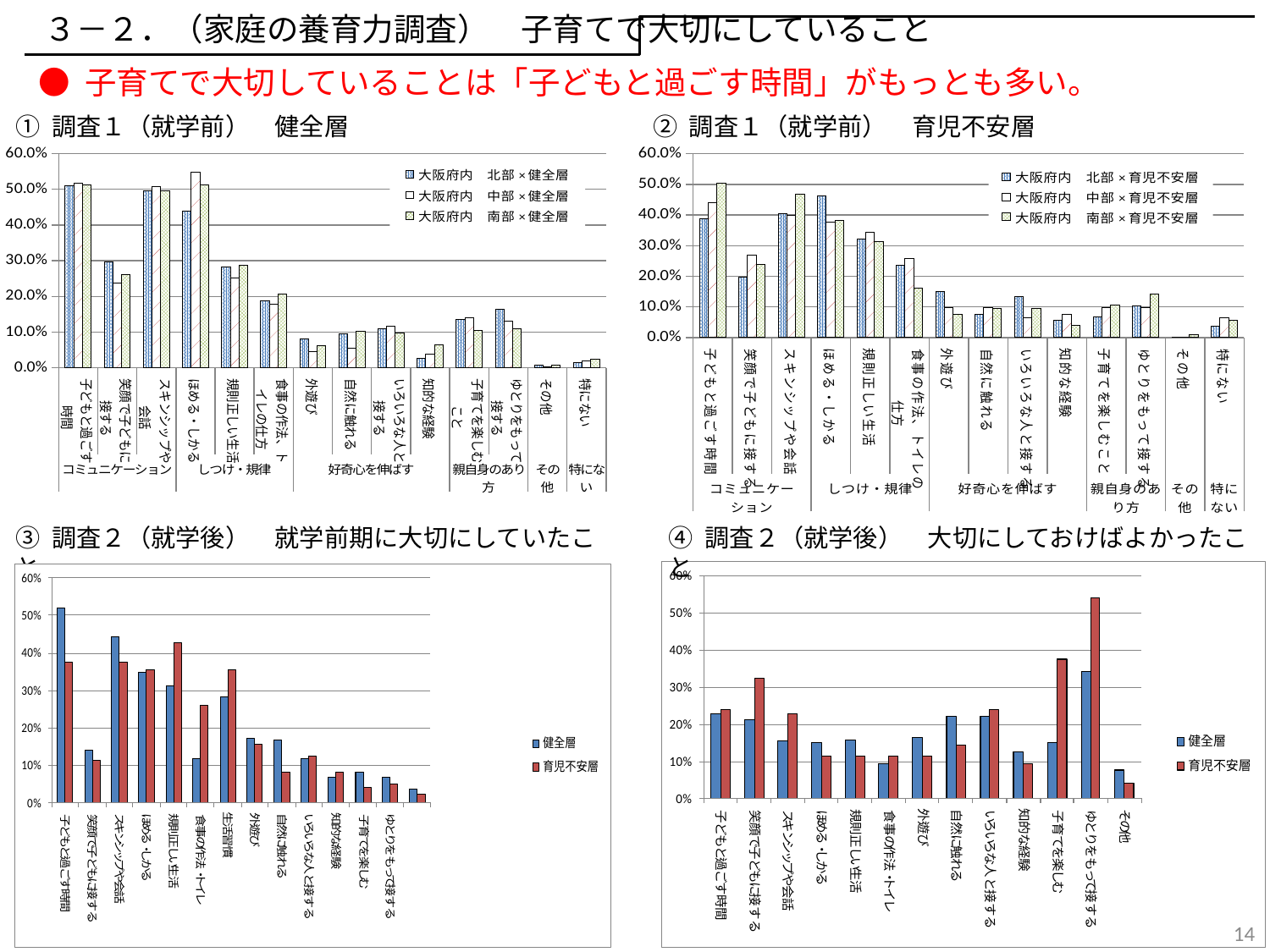
In chart ① 調査１（就学前） 健全層, how many series does the legend list? 3 In chart ② 調査１（就学前） 育児不安層, is the value of 規則正しい生活 for 大阪府内 北部×育児不安層 greater or less than 20.0%? greater In chart ④ 調査２（就学後） 大切にしておけばよかったこと, which category has the highest value for 育児不安層? ゆとりをもって接する In chart ① 調査１（就学前） 健全層, is the value of 子どもと過ごす時間 for 大阪府内 北部×健全層 greater or less than 40.0%? greater In chart ② 調査１（就学前） 育児不安層, which category has the highest value for the 大阪府内 南部×育児不安層 series? 子どもと過ごす時間 In chart ① 調査１（就学前） 健全層, which category has the highest value for the 大阪府内 中部×健全層 series? ほめる・しかる How many charts are shown on the slide? 4 In chart ① 調査１（就学前） 健全層, which category has the lowest values across all three series? その他 What type of chart is chart ③ 調査２（就学後） 就学前期に大切にしていたこと? bar chart In chart ④ 調査２（就学後） 大切にしておけばよかったこと, for 笑顔で子どもに接する, which series has the larger value, 健全層 or 育児不安層? 育児不安層